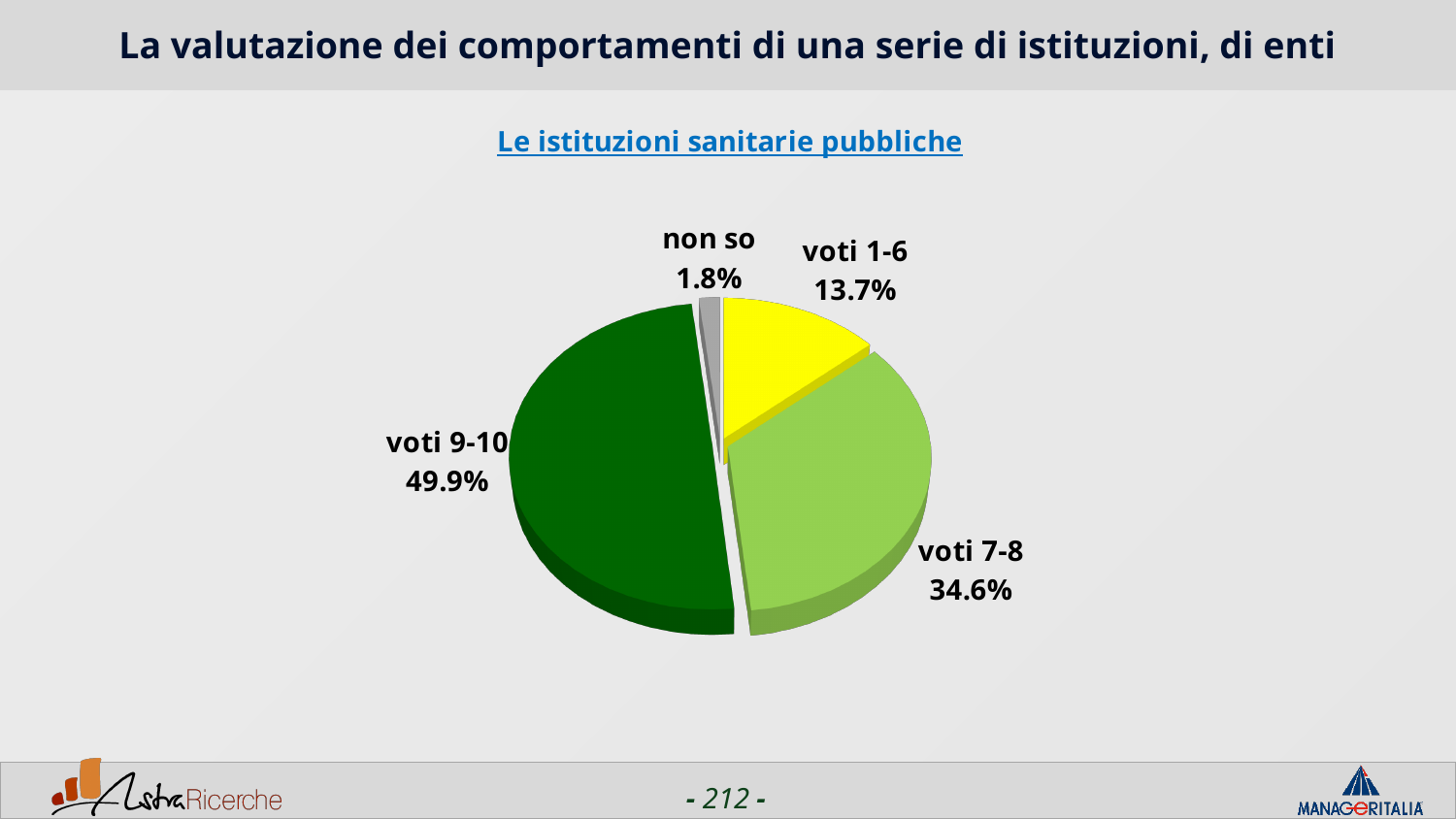
What share of respondents answered 'non so'? 1.8% How many categories are shown in the pie chart? 4 What type of chart is shown on the slide? Pie chart What is the value shown for 'voti 1-6'? 13.7% What is the value shown for 'voti 7-8'? 34.6% What is the combined share of 'voti 7-8' and 'voti 9-10'? 84.5% What percentage of respondents gave 'voti 9-10' to public health institutions? 49.9% Which is larger, the share for 'voti 7-8' or for 'voti 1-6'? voti 7-8 What is the difference between the 'voti 9-10' and 'voti 7-8' shares? 15.3 percentage points What is the subtitle of the chart on the slide? Le istituzioni sanitarie pubbliche Which category has the smallest slice of the pie? non so Which category has the largest slice of the pie? voti 9-10